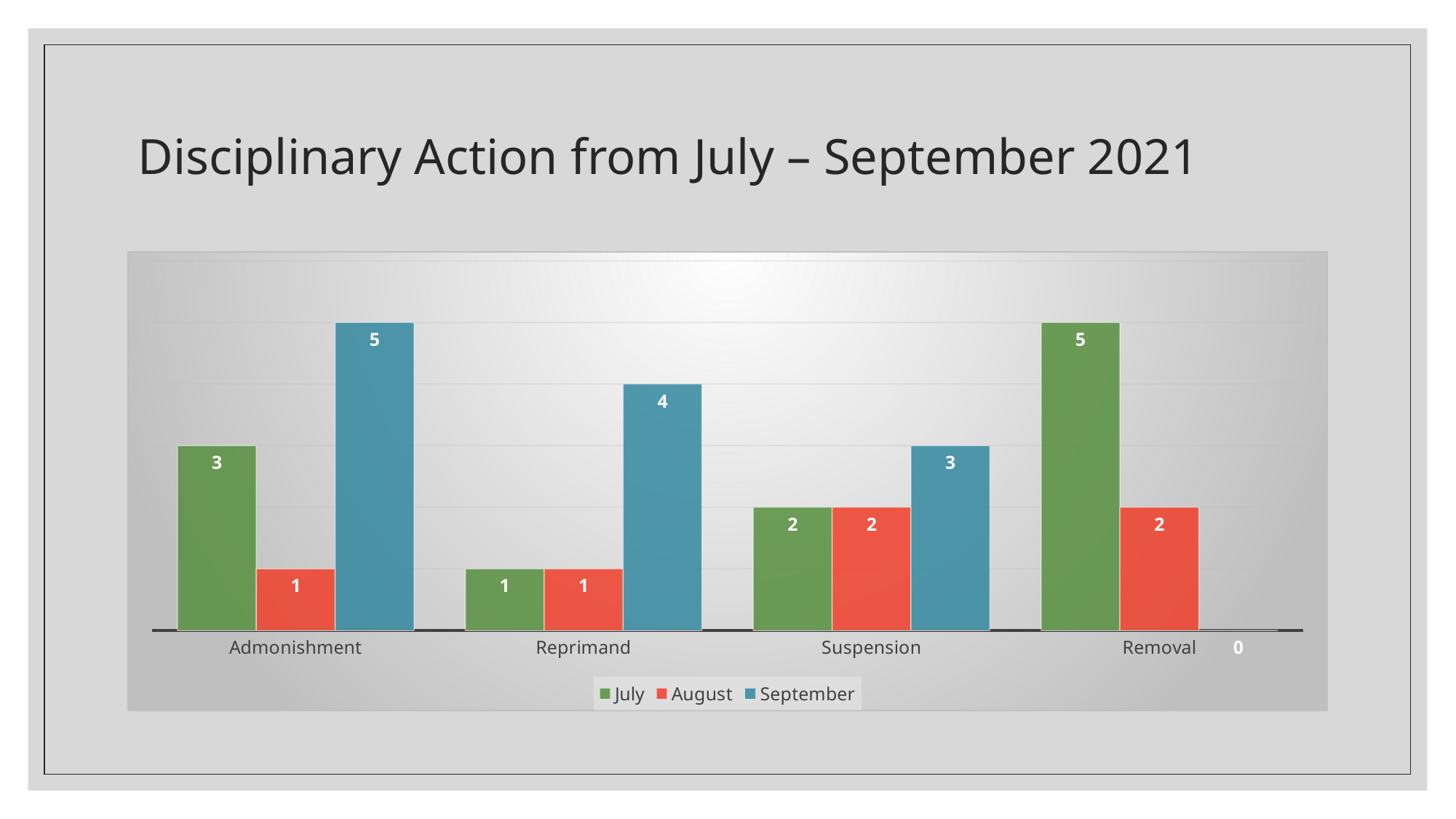
Which is larger, the September value for Reprimand or the September value for Suspension? Reprimand What is the value for July in the Removal category? 5 What is the value for September in the Removal category? 0 What is the value for September in the Admonishment category? 5 What is the title of the chart? Disciplinary Action from July – September 2021 Which category has the highest value for September? Admonishment What is the value for August in the Reprimand category? 1 How many series does the legend list? 3 What kind of chart is shown on the slide? Bar chart Which category has the lowest value for July? Reprimand How many categories are shown on the x axis? 4 What is the difference between the September and July values for Admonishment? 2